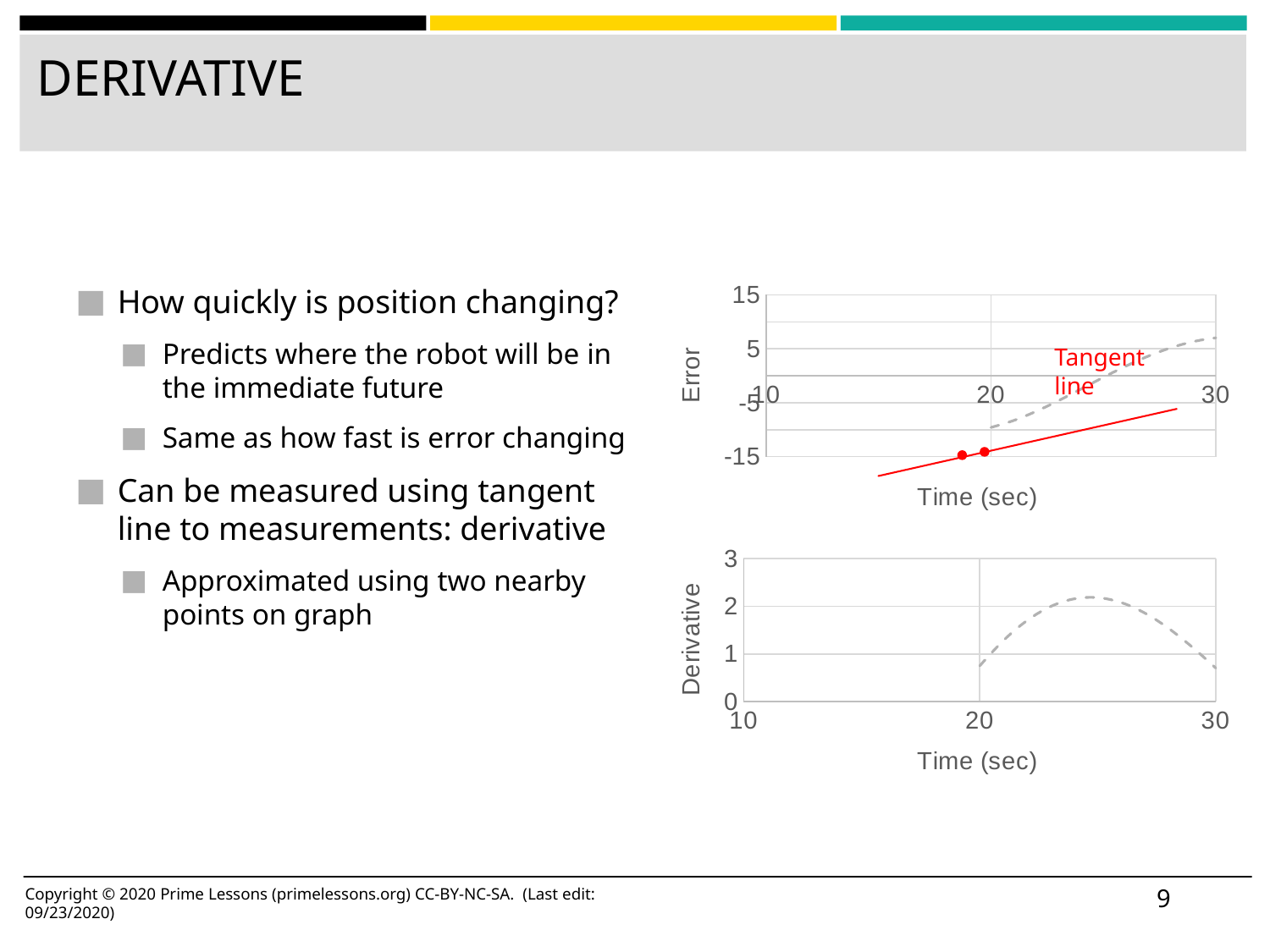
In the top chart, how many red points are marked on the tangent line? 2 In the top chart, what is the label on the vertical axis? Error In the top chart, is the value of the dashed curve at time 20 greater or less than -5? less In the bottom chart, is the peak of the derivative curve greater or less than 2? greater In the bottom chart, is the derivative value at time 20 greater or less than 1? less What kind of chart is the top chart on the slide? line chart How many charts are shown on the slide? 2 What kind of chart is the bottom chart on the slide? line chart In the bottom chart, what is the label on the vertical axis? Derivative In the top chart, does the dashed error curve rise or fall between time 20 and time 30? rise